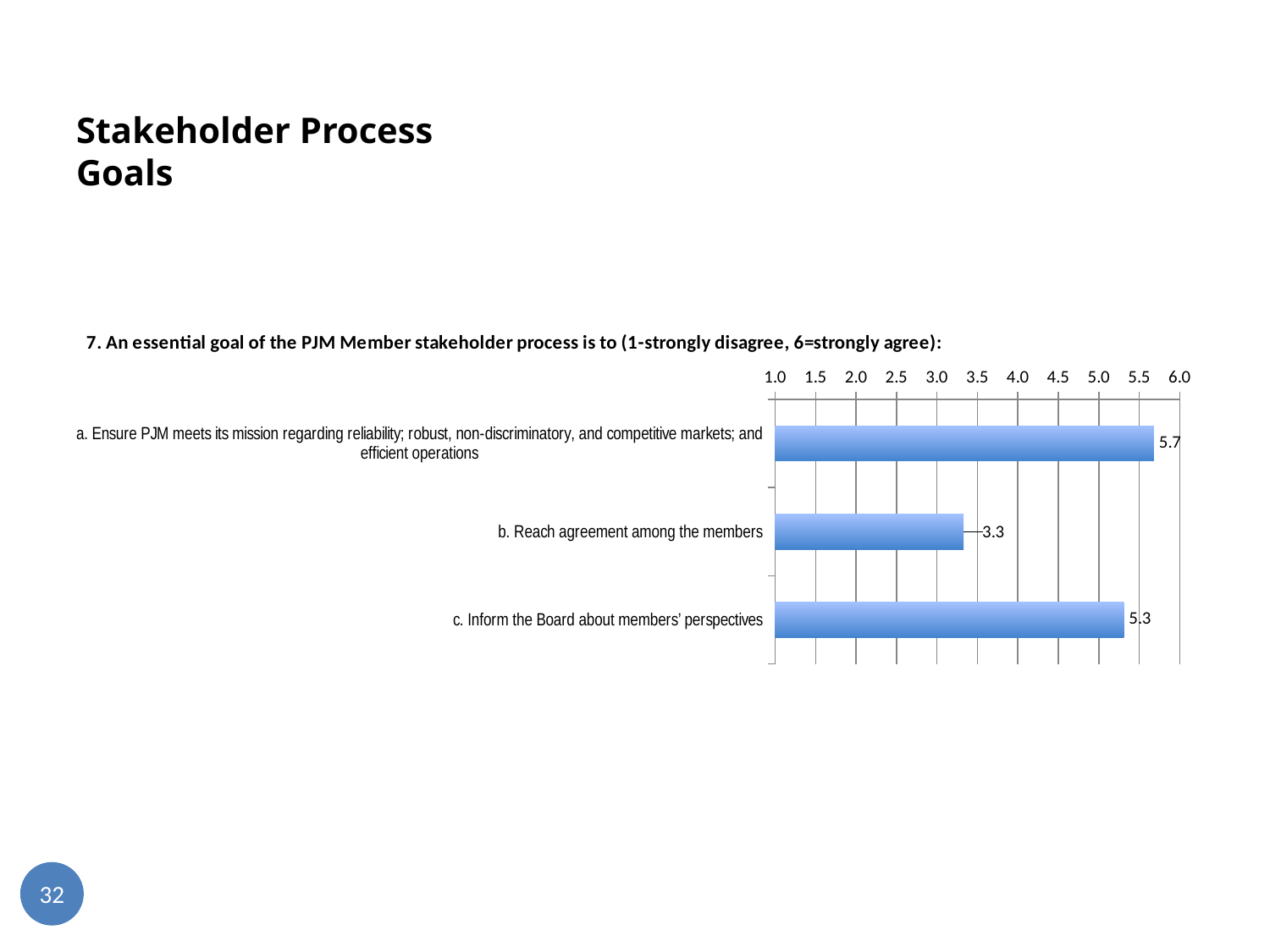
Which category has the lowest value? b. Reach agreement among the members Is the value for "b. Reach agreement among the members" greater or less than 4.0? less What is the maximum value shown on the chart's value axis? 6.0 What is the difference between the values for "a. Ensure PJM meets its mission..." and "b. Reach agreement among the members"? 2.4 Which category has the highest value? a. Ensure PJM meets its mission regarding reliability; robust, non-discriminatory, and competitive markets; and efficient operations Which has a larger value: "c. Inform the Board about members' perspectives" or "b. Reach agreement among the members"? c. Inform the Board about members' perspectives What is the value for "a. Ensure PJM meets its mission regarding reliability; robust, non-discriminatory, and competitive markets; and efficient operations"? 5.7 What kind of chart is shown on the slide? bar chart How many categories are shown in the chart? 3 What is the value for "c. Inform the Board about members' perspectives"? 5.3 What is the value for "b. Reach agreement among the members"? 3.3 What is the difference between the values for "c. Inform the Board about members' perspectives" and "b. Reach agreement among the members"? 2.0